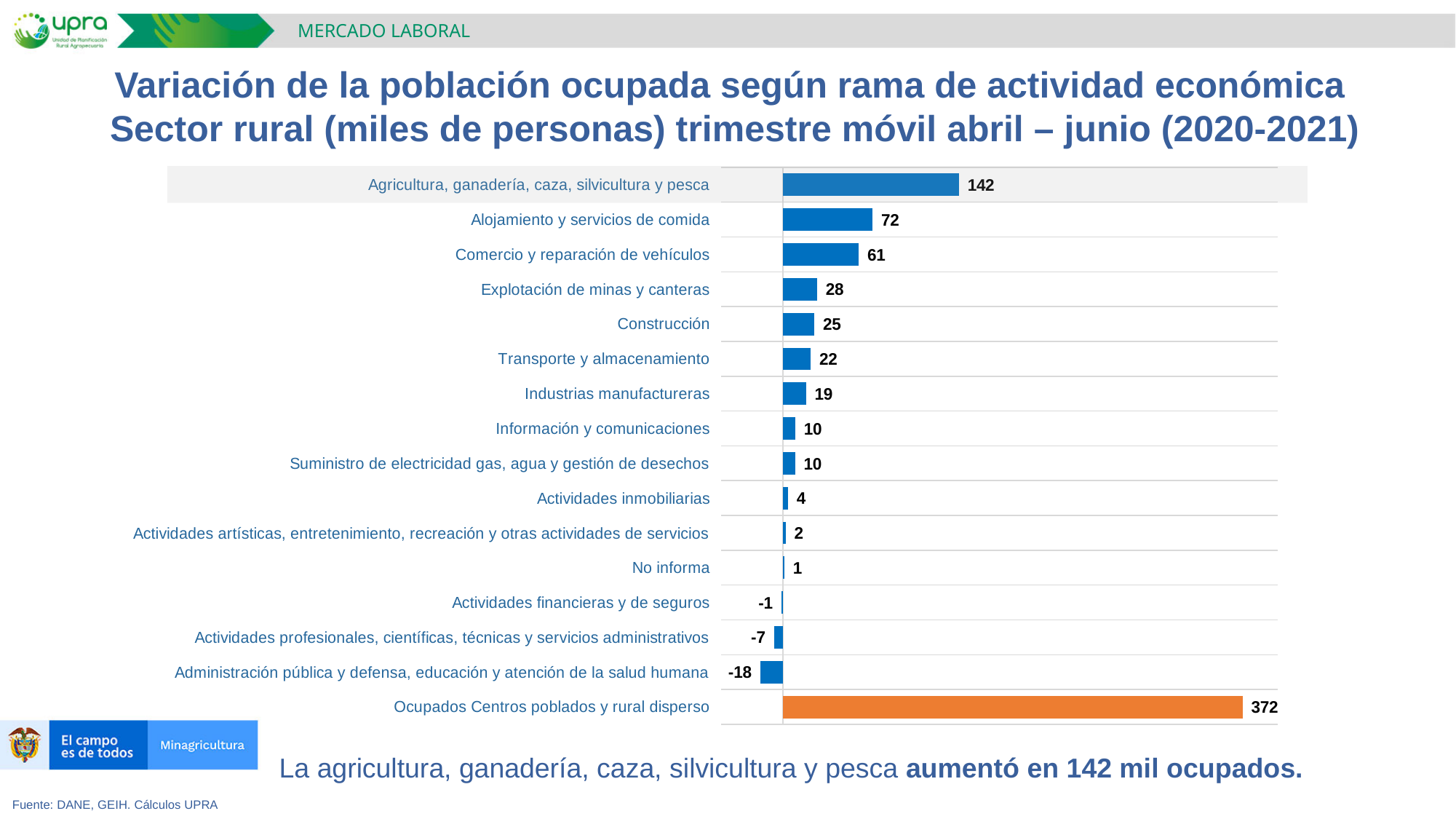
Which is larger, the value for Explotación de minas y canteras or the value for Construcción? Explotación de minas y canteras What is the value for Comercio y reparación de vehículos? 61 How many categories are shown in the chart? 16 What is the difference between the values for Alojamiento y servicios de comida and Comercio y reparación de vehículos? 11 What is the value for Administración pública y defensa, educación y atención de la salud humana? -18 Which category has the highest value? Ocupados Centros poblados y rural disperso What is the value for Agricultura, ganadería, caza, silvicultura y pesca? 142 What is the value for Ocupados Centros poblados y rural disperso? 372 What kind of chart is shown on the slide? Bar chart How many categories have a negative value? 3 What colour is the bar for Ocupados Centros poblados y rural disperso? Orange Which category has the lowest value? Administración pública y defensa, educación y atención de la salud humana